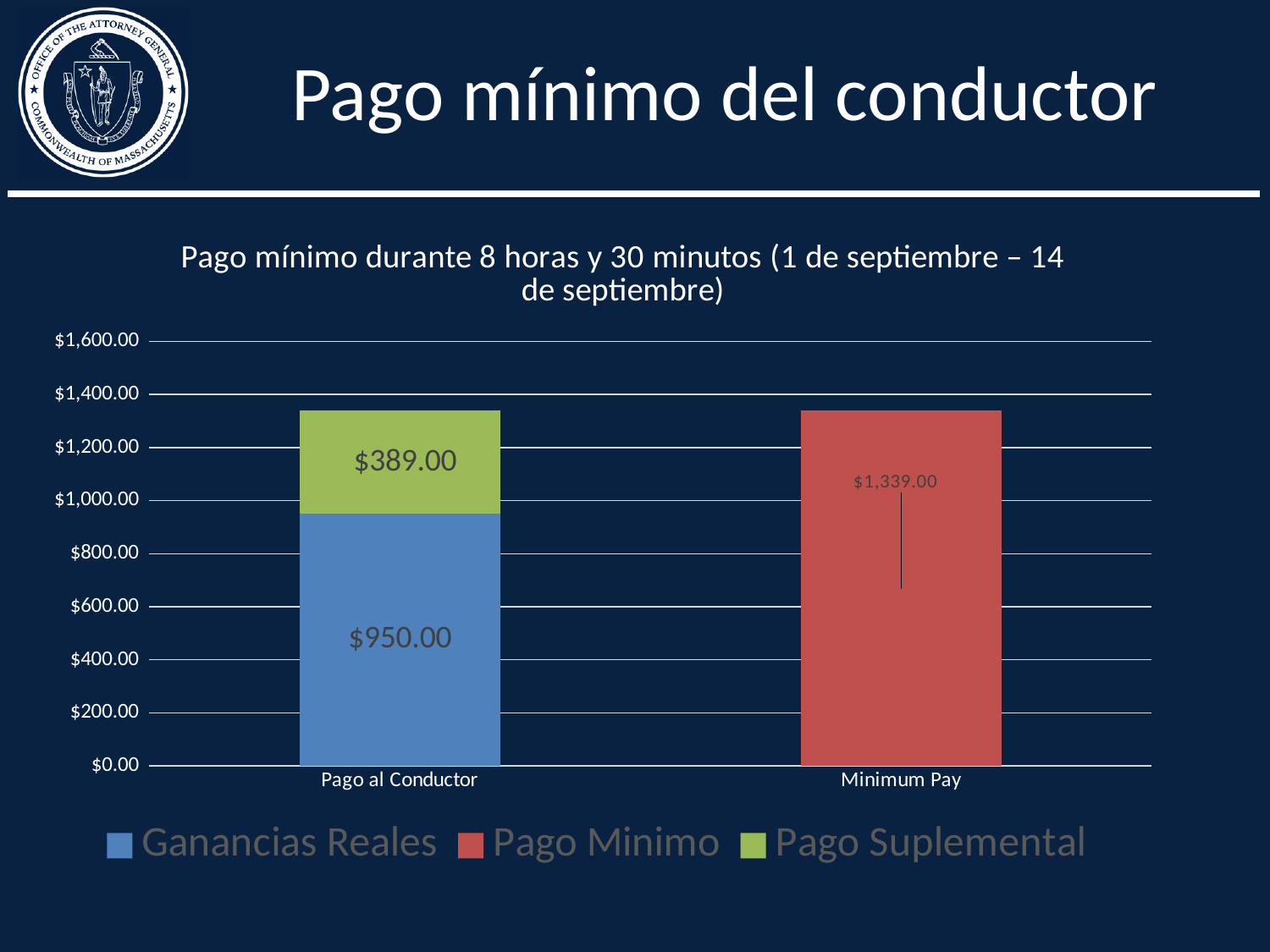
Which is larger for Pago al Conductor, the Ganancias Reales segment or the Pago Suplemental segment? Ganancias Reales What colour represents Pago Minimo in the legend? Red What kind of chart is shown on the slide? Stacked bar chart What is the total of the stacked bar for Pago al Conductor? $1,339.00 What is the value of the Ganancias Reales segment for Pago al Conductor? $950.00 Is the value for Minimum Pay greater or less than $1,200.00? greater What is the value shown for Minimum Pay? $1,339.00 Is the Ganancias Reales segment for Pago al Conductor greater or less than $1,000.00? less How many categories are shown on the x axis? 2 What is the value of the Pago Suplemental segment for Pago al Conductor? $389.00 How many series does the legend list? 3 What is the difference between the Ganancias Reales segment and the Pago Suplemental segment for Pago al Conductor? $561.00